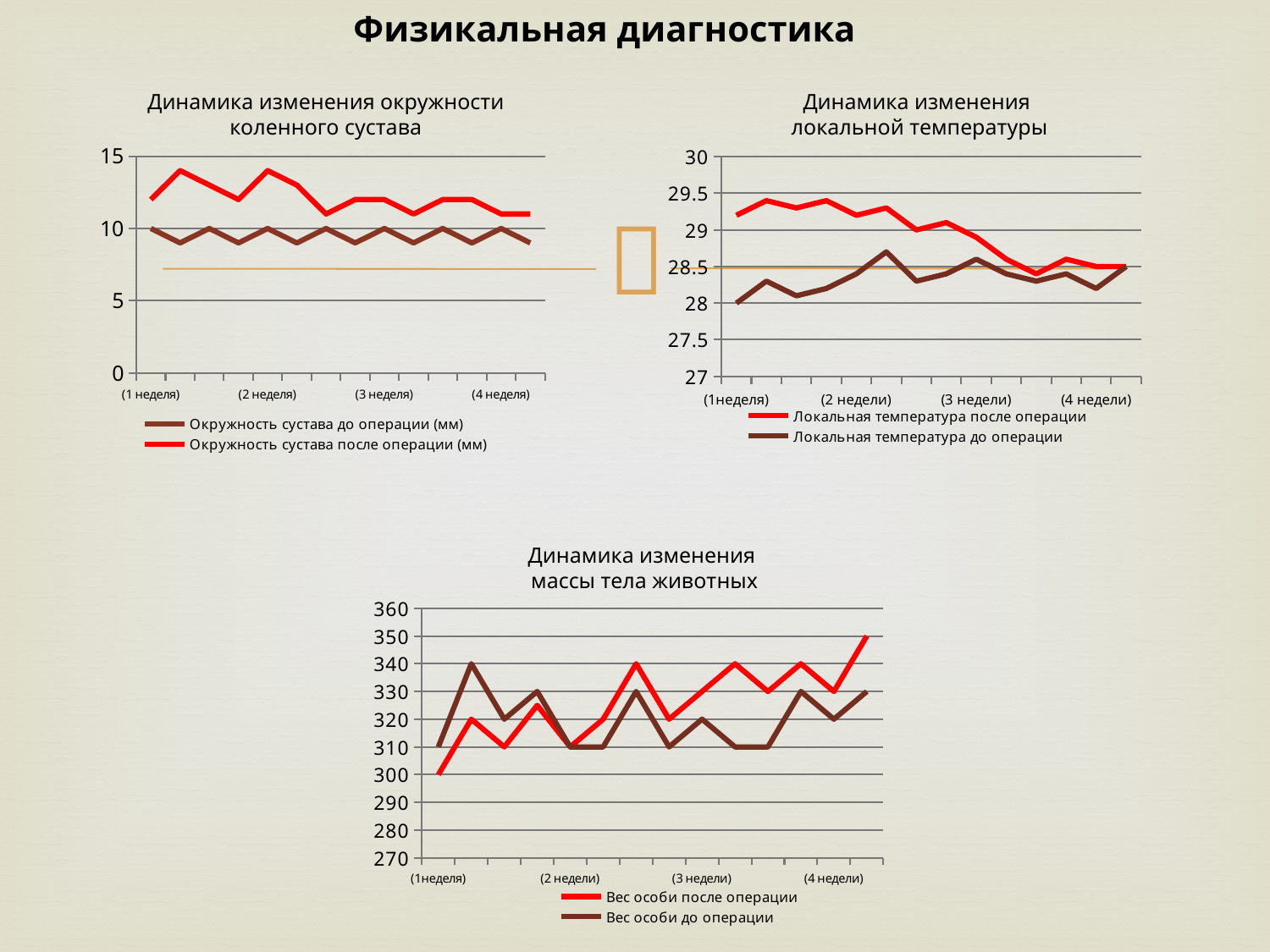
In 'Динамика изменения окружности коленного сустава', is the first value of 'Окружность сустава после операции (мм)' greater or less than 10? greater What kind of chart is 'Динамика изменения массы тела животных'? line chart In 'Динамика изменения локальной температуры', what is the first value of 'Локальная температура до операции' at (1неделя)? 28 In 'Динамика изменения локальной температуры', does 'Локальная температура после операции' generally rise or fall from week 1 to week 4? fall How many series does the legend of 'Динамика изменения окружности коленного сустава' list? 2 In 'Динамика изменения массы тела животных', what is the final value of 'Вес особи после операции' at the end of the series? 350 In 'Динамика изменения окружности коленного сустава', which series is higher at (1 неделя)? Окружность сустава после операции (мм) In 'Динамика изменения массы тела животных', what is the difference between the last and first values of 'Вес особи после операции'? 50 In 'Динамика изменения массы тела животных', what is the first value of 'Вес особи до операции' at (1неделя)? 310 In 'Динамика изменения локальной температуры', is the first value of 'Локальная температура после операции' greater or less than 29? greater In 'Динамика изменения массы тела животных', what is the first value of 'Вес особи после операции' at (1неделя)? 300 In 'Динамика изменения массы тела животных', what is the highest value reached by 'Вес особи после операции'? 350